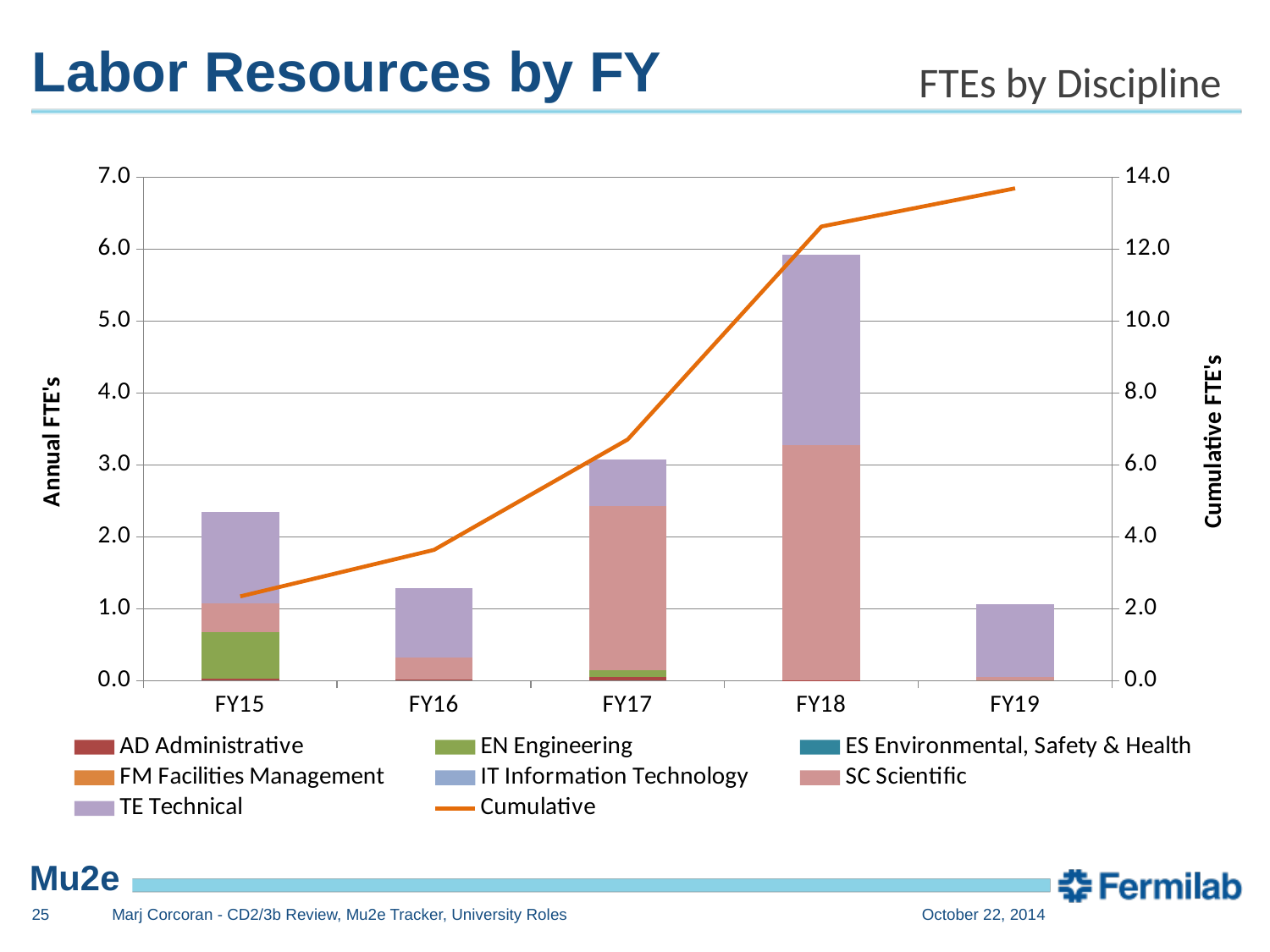
Which series is plotted as a line rather than bars? Cumulative Which has the larger total annual FTE bar, FY16 or FY17? FY17 How many series does the legend list? 8 What kind of chart is shown on the slide? Stacked bar chart with a line Is the total annual FTE bar for FY15 greater or less than 2.0? greater Is the total annual FTE bar for FY16 greater or less than 2.0? less What is the title of the right-hand vertical axis? Cumulative FTE's Is the total annual FTE bar for FY17 greater or less than 4.0? less How many fiscal years are shown on the x axis? 5 Which fiscal year has the tallest stacked bar of annual FTEs? FY18 Does the Cumulative line rise or fall from FY15 to FY19? Rises